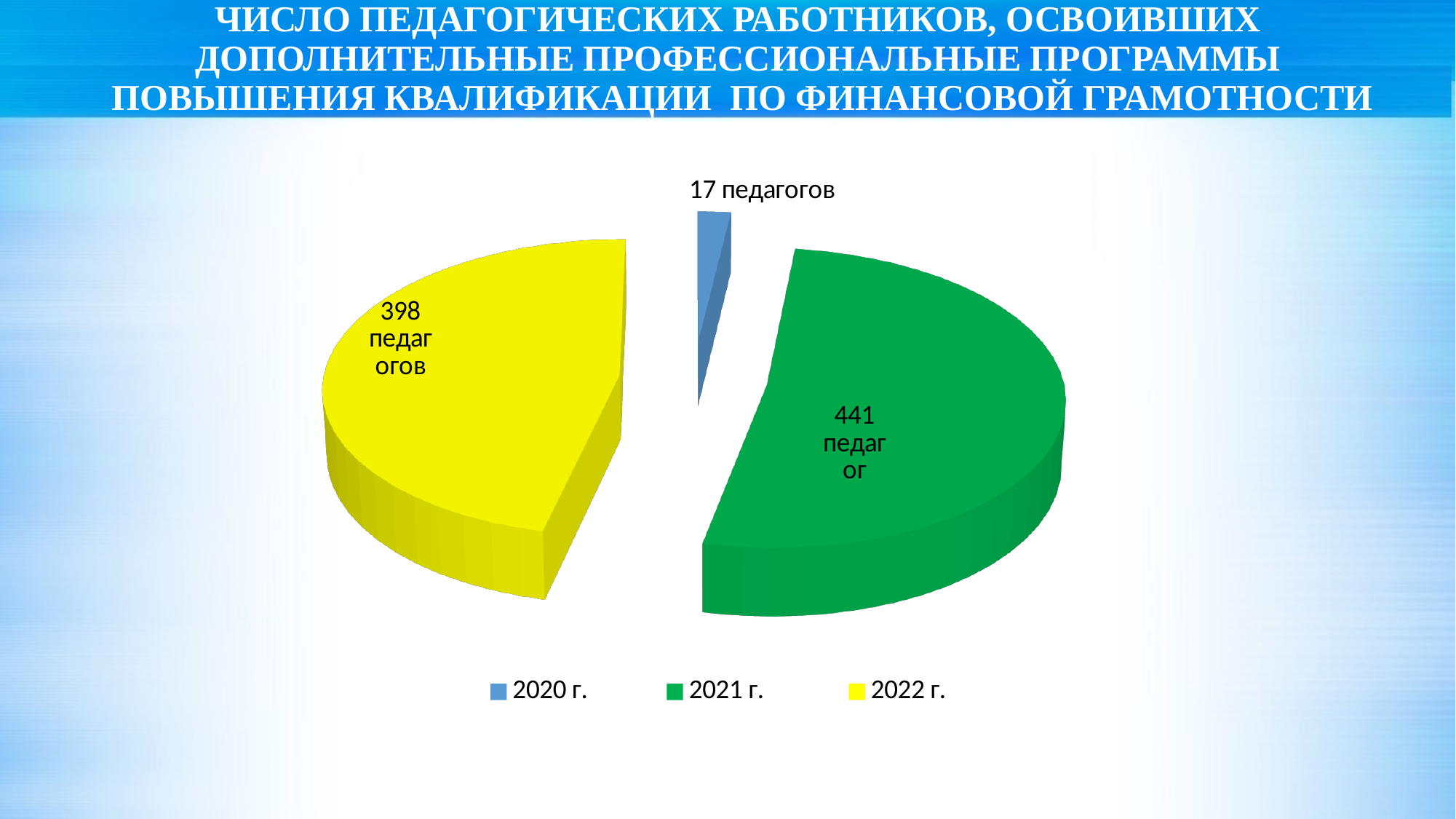
Which year has the largest number of teachers? 2021 г. What type of chart is shown on the slide? Pie chart What is the difference between the number of teachers in 2021 г. and 2022 г.? 43 How many entries does the legend list? 3 What value is shown for 2020 г.? 17 педагогов What value is shown for 2022 г.? 398 педагогов What is the difference between the number of teachers in 2022 г. and 2020 г.? 381 Which year has the smallest number of teachers? 2020 г. How many slices does the pie chart have? 3 Which is larger: the value for 2021 г. or the value for 2022 г.? 2021 г. What value is shown for 2021 г.? 441 педагог What colour is the slice for 2022 г.? Yellow